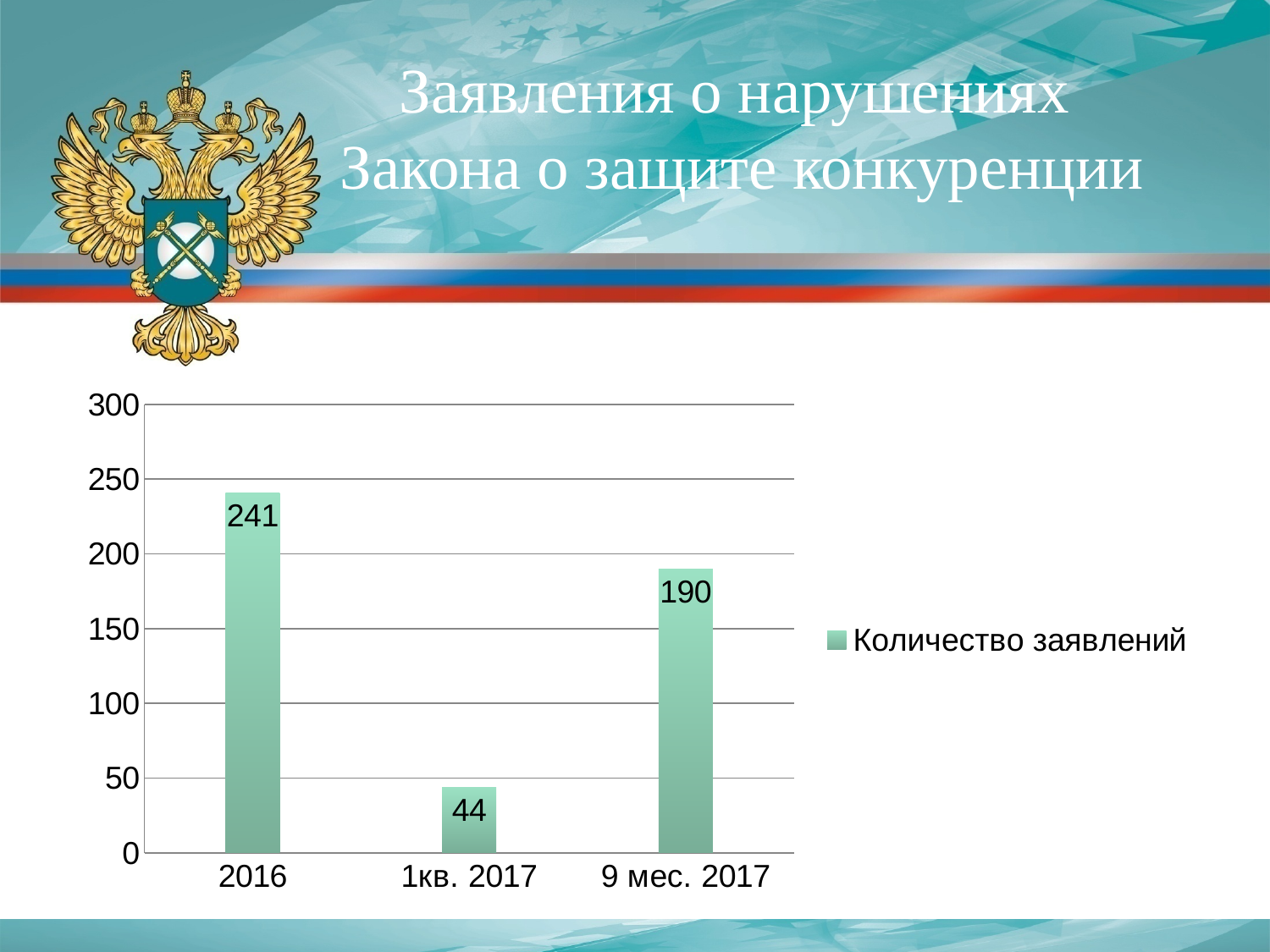
What is the difference between the values for 9 мес. 2017 and 1кв. 2017? 146 How many categories are shown on the x axis? 3 What is the value for 2016? 241 What kind of chart is shown on the slide? bar chart Which category has the highest value? 2016 Which is larger, the value for 2016 or the value for 9 мес. 2017? 2016 What is the value for 1кв. 2017? 44 What is the value for 9 мес. 2017? 190 Is the value for 9 мес. 2017 greater or less than 200? less Which category has the lowest value? 1кв. 2017 How many series does the legend list? 1 What is the difference between the values for 2016 and 9 мес. 2017? 51